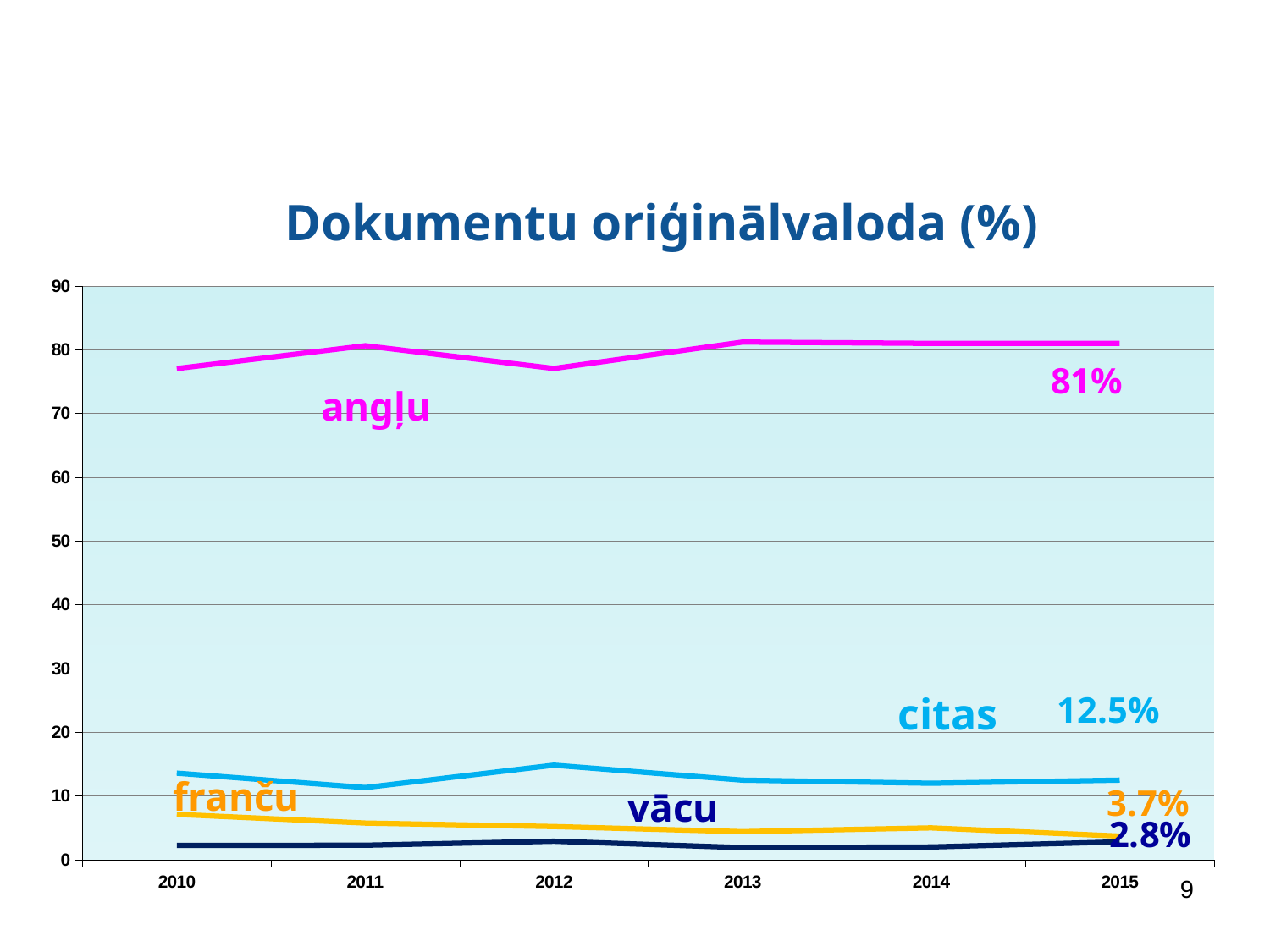
How many years are shown on the x axis? 6 What is the difference between the angļu and citas values in 2015? 68.5% Which language series has the highest value in 2015? angļu Does the franču line rise or fall from 2010 to 2015? fall What is the value for vācu in 2015? 2.8% What kind of chart is shown on the slide? line chart What is the title of the chart? Dokumentu oriģinālvaloda (%) Which language series has the lowest value in 2015? vācu What is the value for angļu in 2015? 81% What is the value for citas in 2015? 12.5% Is the value for angļu in 2012 greater or less than 80? less What is the value for franču in 2015? 3.7%